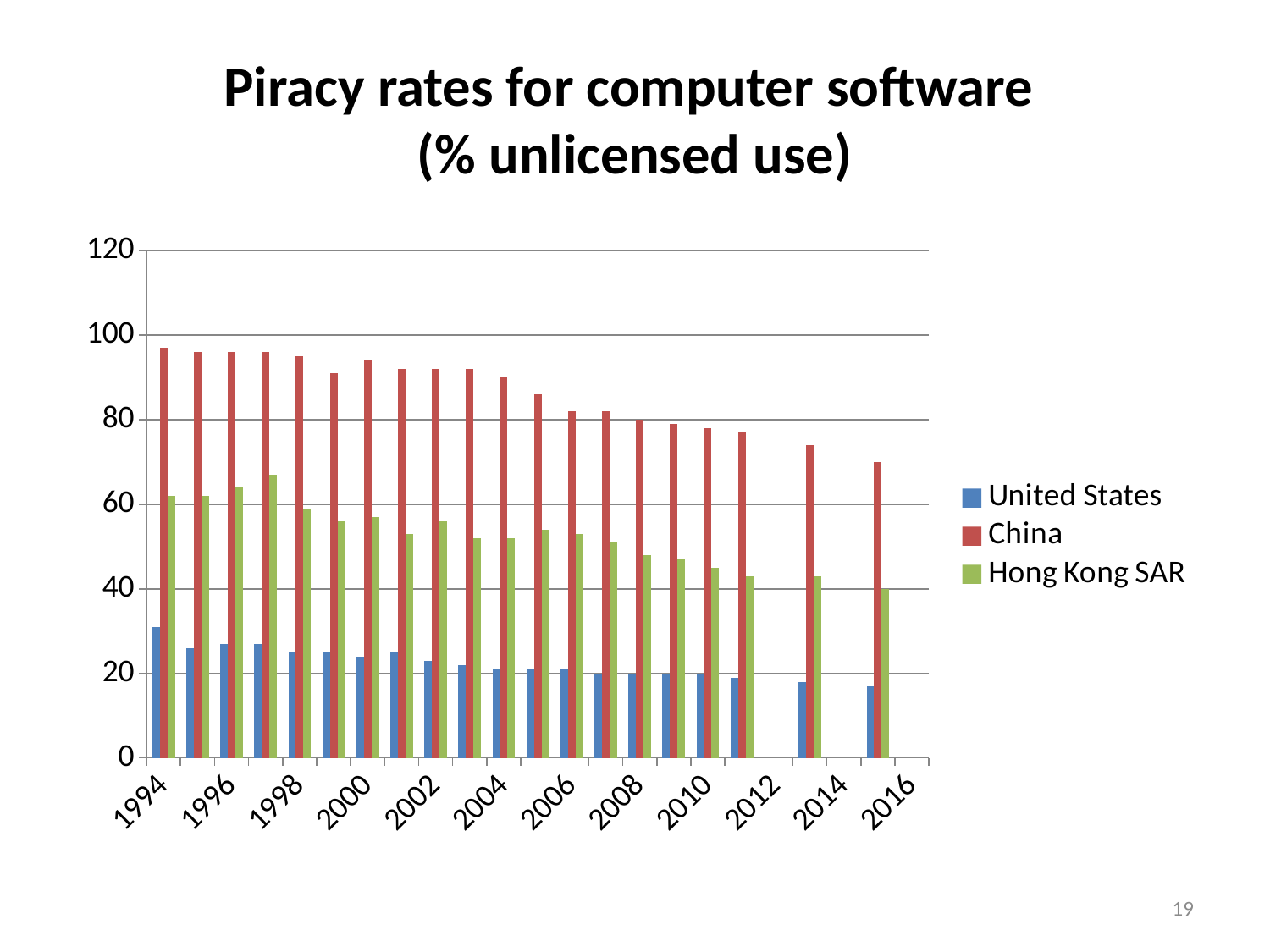
Which series is shown in red in the legend? China Which series has the highest value in 1994? China Is the value for the United States in 1994 greater or less than 20? greater Do the values for China rise or fall from 1994 to 2015? fall In 2000, which is larger: the value for China or the value for Hong Kong SAR? China What kind of chart is shown on the slide? bar chart Is the value for China in 1994 greater or less than 80? greater Is the value for the United States in 2015 greater or less than 20? less Which series has the lowest value in 2010? United States How many series does the legend list? 3